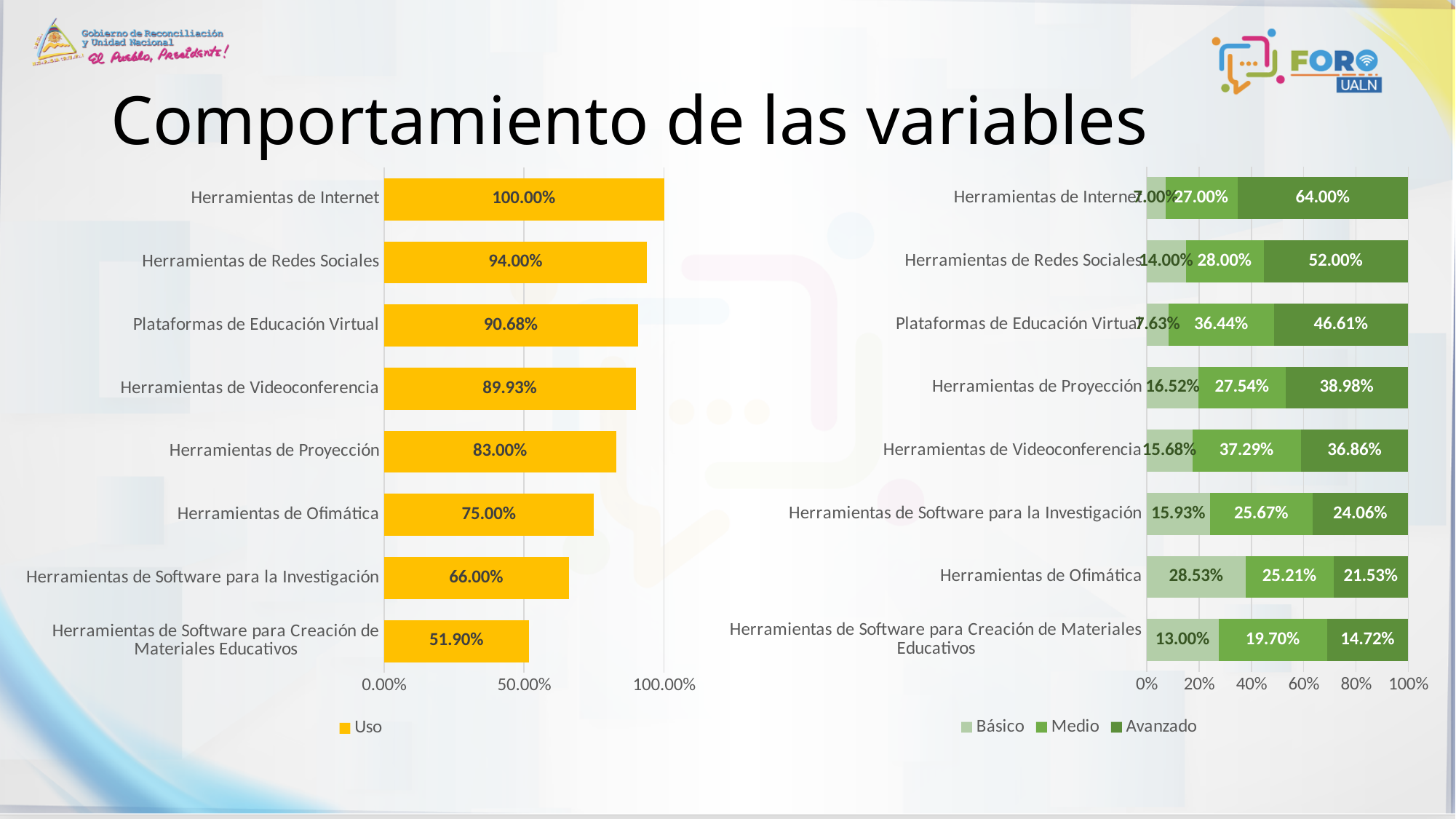
In the left chart (Uso), which category has the lowest value? Herramientas de Software para Creación de Materiales Educativos In the left chart (Uso), what is the difference between Herramientas de Redes Sociales and Herramientas de Proyección? 11.00% In the right chart, what is the Básico value for Herramientas de Ofimática? 28.53% In the right chart, what is the Medio value for Herramientas de Videoconferencia? 37.29% In the left chart (Uso), what is the value for Plataformas de Educación Virtual? 90.68% In the right chart, what is the total of the stacked bar for Herramientas de Ofimática? 75.27% In the right chart, is the Avanzado value for Herramientas de Proyección larger or smaller than the Avanzado value for Herramientas de Ofimática? larger In the right chart, how many series does the legend list? 3 In the left chart (Uso), what is the value for Herramientas de Software para Creación de Materiales Educativos? 51.90% In the right chart, what is the Avanzado value for Herramientas de Internet? 64.00% In the left chart (Uso), how many categories are shown? 8 In the left chart (Uso), which category has the highest value? Herramientas de Internet